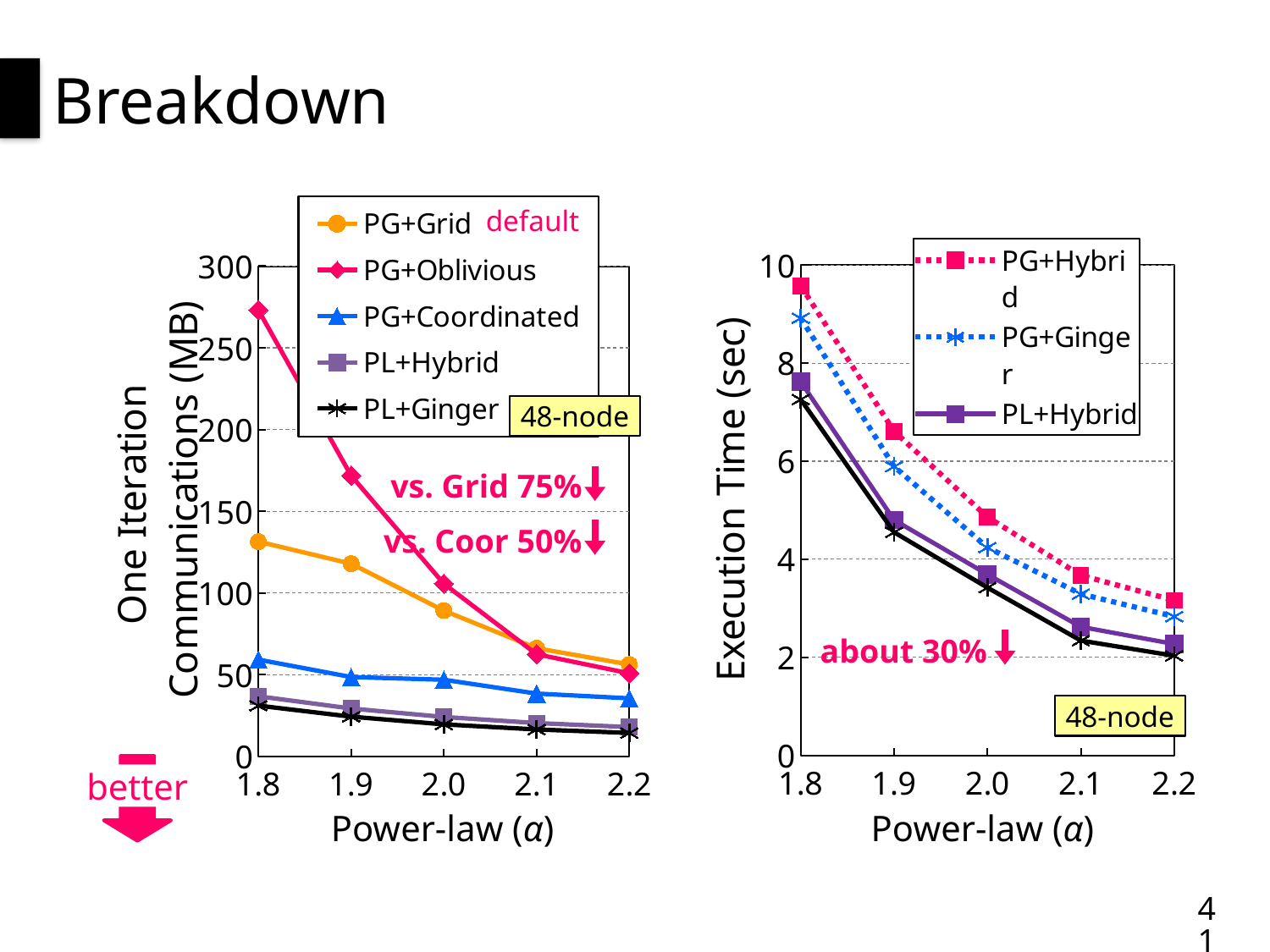
How many series does the legend of the left chart (One Iteration Communications) list? 5 In the left chart (One Iteration Communications), which series has the highest value at α = 1.8? PG+Oblivious What kind of chart is the left chart (One Iteration Communications)? line chart How many Power-law (α) values are plotted along the x axis of the left chart (One Iteration Communications)? 5 In the left chart (One Iteration Communications), is the value for PG+Grid at α = 1.8 greater or less than 150? less In the right chart (Execution Time), which is larger at α = 2.2: PG+Hybrid or PL+Hybrid? PG+Hybrid In the left chart (One Iteration Communications), which series has the lowest value at α = 2.2? PL+Ginger How many series does the legend of the right chart (Execution Time) list? 3 In the left chart (One Iteration Communications), do the values for PG+Oblivious rise or fall as α increases from 1.8 to 2.2? fall In the left chart (One Iteration Communications), is the value for PG+Oblivious at α = 1.8 greater or less than 250? greater In the right chart (Execution Time), which series has the highest value at α = 1.8? PG+Hybrid In the right chart (Execution Time), is the value for PG+Hybrid at α = 1.8 greater or less than 8? greater